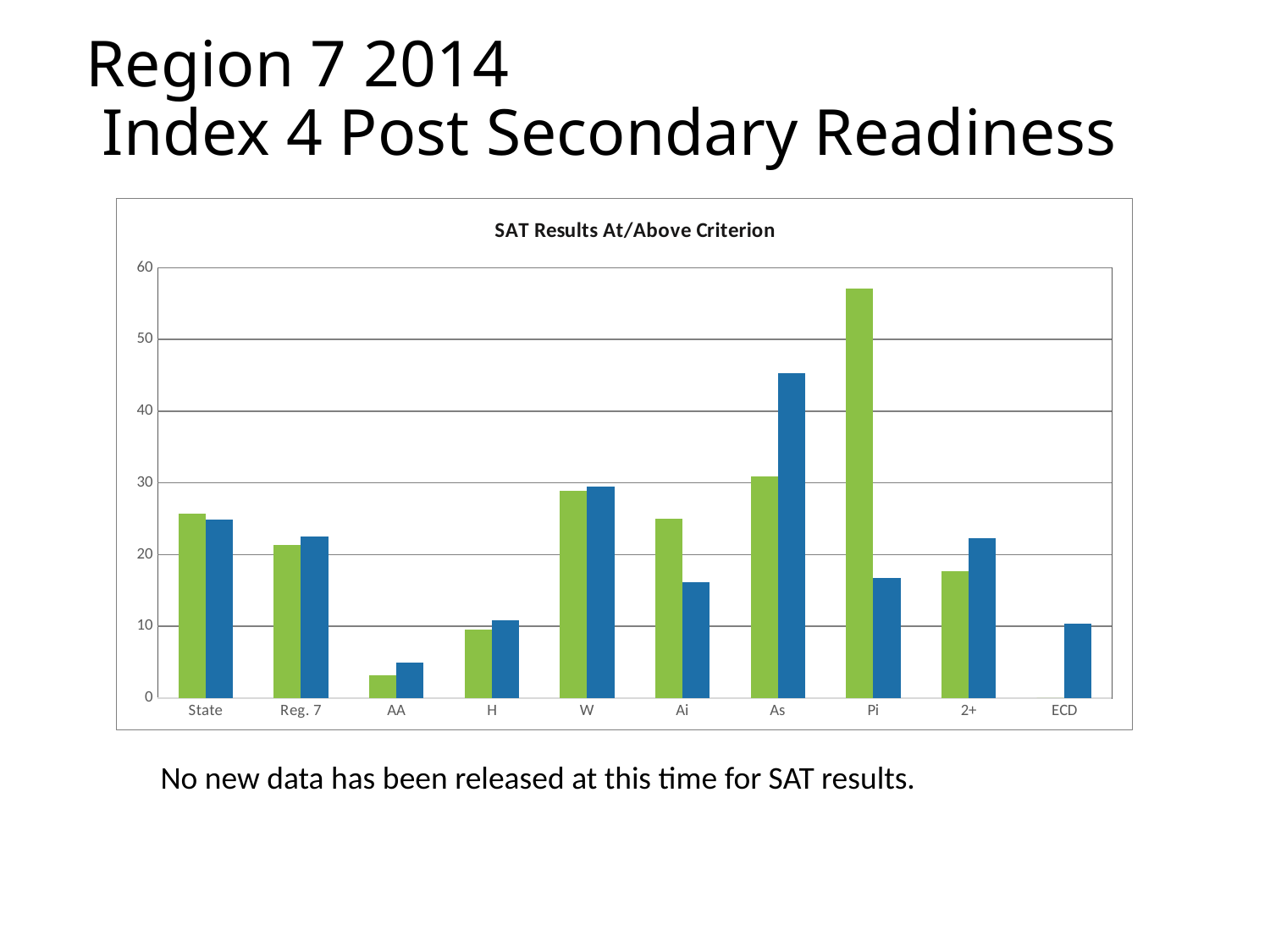
Which category has the shortest green bar? AA For the Pi category, which bar is taller, the green or the blue? green What is the title of the chart? SAT Results At/Above Criterion Which category has the tallest green bar? Pi Which category has the tallest blue bar? As How many categories are shown on the x axis of the chart? 10 Is the blue bar for Ai greater or less than 20? less Is the green bar for AA greater or less than 10? less Is the green bar for Pi greater or less than 50? greater Which category on the x axis has only a blue bar and no green bar? ECD What kind of chart is shown on the slide? bar chart